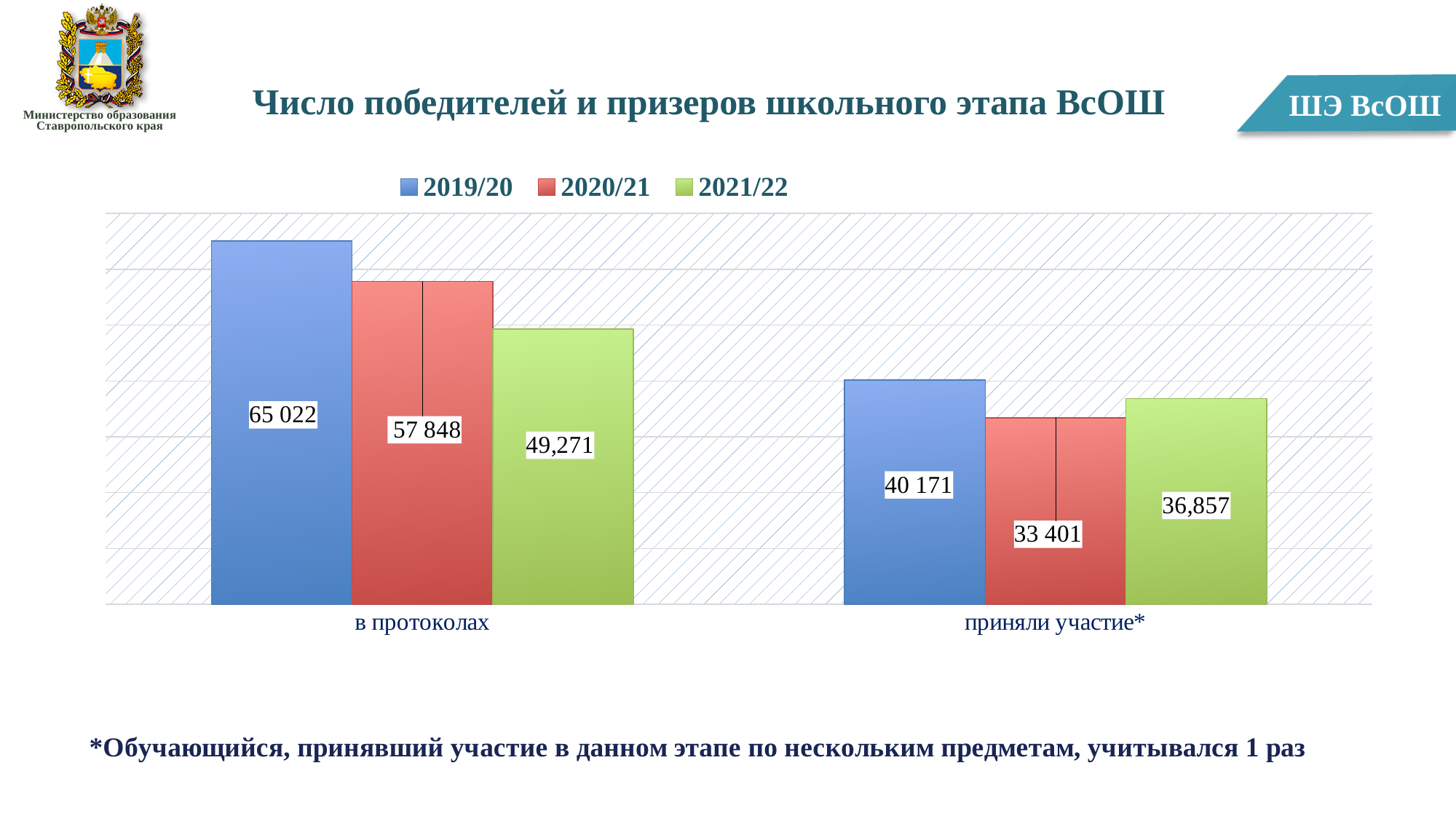
Which is larger in the "приняли участие*" category: 2020/21 or 2021/22? 2021/22 What kind of chart is shown on the slide? Bar chart How many series does the legend list? 3 What is the difference between the 2019/20 and 2020/21 values in the "в протоколах" category? 7 174 What is the value for 2020/21 in the "приняли участие*" category? 33 401 Which series has the lowest value in the "приняли участие*" category? 2020/21 Which series has the highest value in the "в протоколах" category? 2019/20 What is the value for 2019/20 in the "в протоколах" category? 65 022 What is the value for 2021/22 in the "в протоколах" category? 49,271 How many categories are shown on the x axis? 2 What is the value for 2021/22 in the "приняли участие*" category? 36,857 What is the difference between the 2019/20 and 2020/21 values in the "приняли участие*" category? 6 770